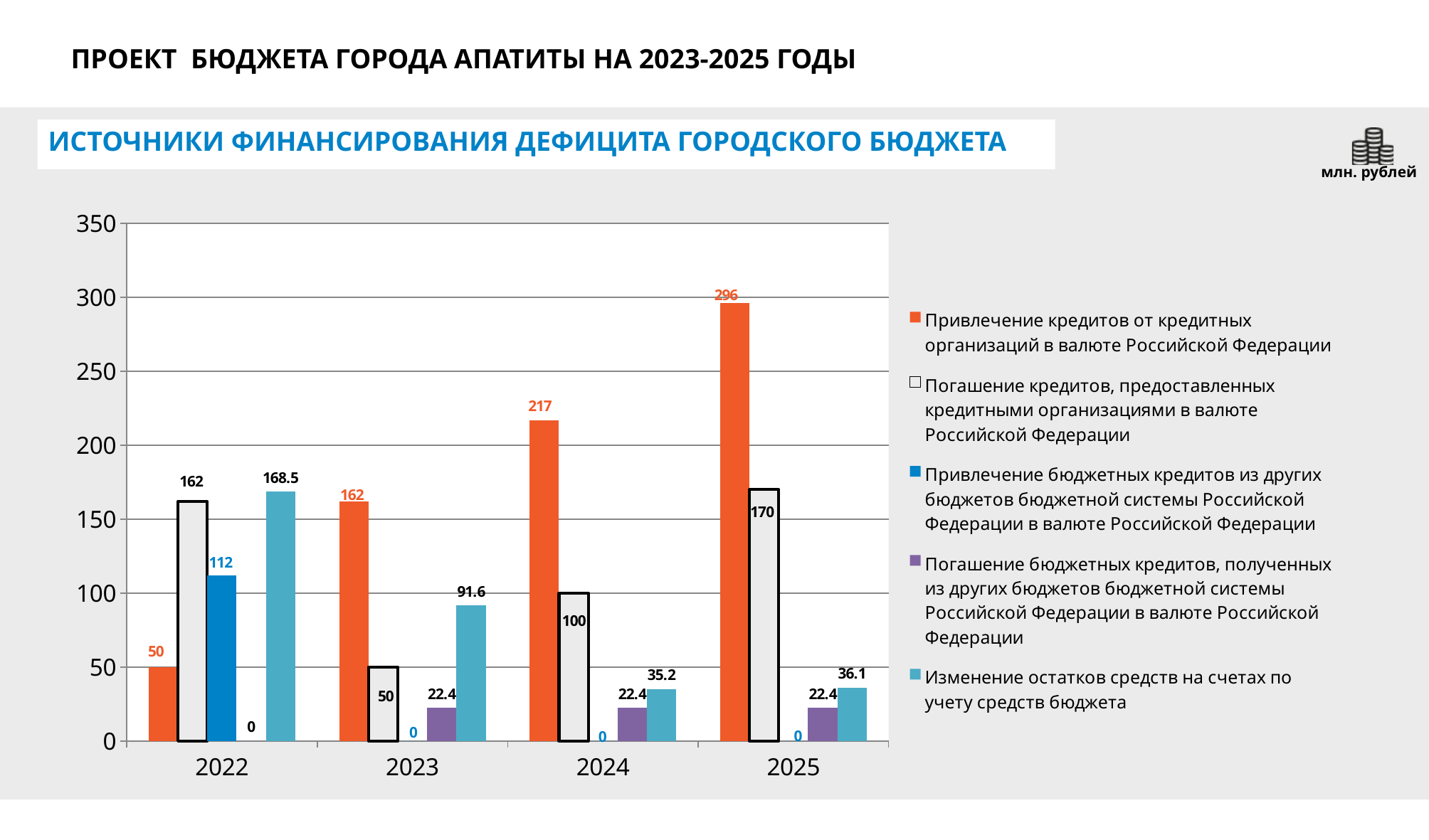
What is the value for "Изменение остатков средств на счетах по учету средств бюджета" in 2022? 168.5 What kind of chart is shown on the slide? Bar chart What is the value for "Привлечение кредитов от кредитных организаций в валюте Российской Федерации" in 2025? 296 What is the difference between the 2025 and 2024 values for "Привлечение кредитов от кредитных организаций в валюте Российской Федерации"? 79 Does the value for "Привлечение кредитов от кредитных организаций в валюте Российской Федерации" rise or fall from 2022 to 2025? Rise How many series does the legend list? 5 What is the value for "Погашение кредитов, предоставленных кредитными организациями в валюте Российской Федерации" in 2024? 100 In which year is the value for "Привлечение кредитов от кредитных организаций в валюте Российской Федерации" the highest? 2025 In which year is the value for "Изменение остатков средств на счетах по учету средств бюджета" the lowest? 2024 Which is larger in 2023: "Привлечение кредитов от кредитных организаций в валюте Российской Федерации" or "Изменение остатков средств на счетах по учету средств бюджета"? Привлечение кредитов от кредитных организаций в валюте Российской Федерации What is the value for "Привлечение бюджетных кредитов из других бюджетов бюджетной системы Российской Федерации в валюте Российской Федерации" in 2022? 112 How many years are shown on the x axis? 4